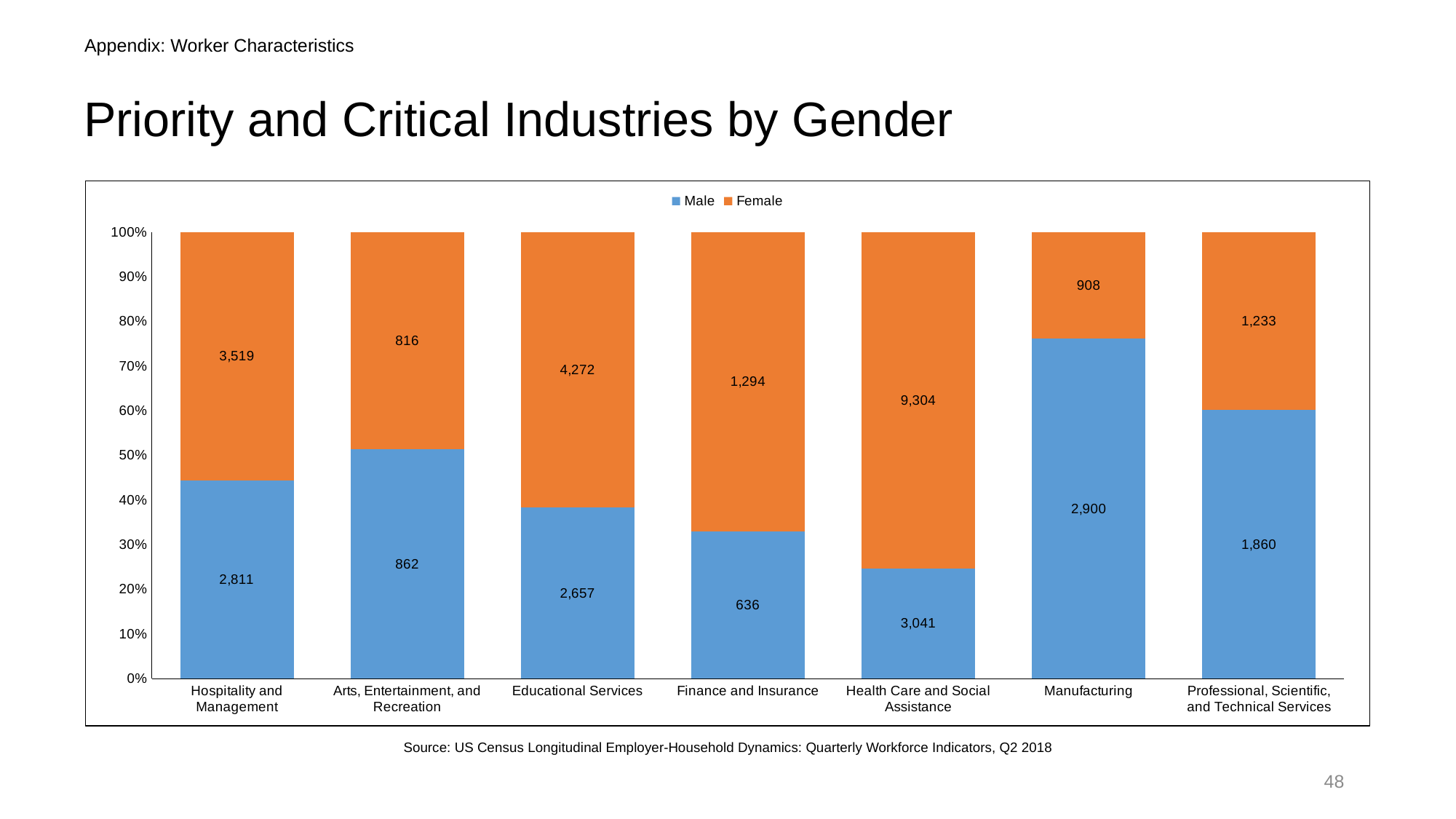
Which industry has the lowest Male value? Finance and Insurance Which is larger for Manufacturing, the Male value or the Female value? Male Which industry has the highest Female value? Health Care and Social Assistance What kind of chart is shown on the slide? Stacked bar chart How many industries are shown on the x axis? 7 What is the difference between the Female and Male values for Health Care and Social Assistance? 6,263 What is the total of the Male and Female values for Manufacturing? 3,808 What is the Male value for Health Care and Social Assistance? 3,041 What is the Male value for Finance and Insurance? 636 What is the Female value for Educational Services? 4,272 Is the Male share of the Manufacturing bar greater or less than 70%? greater How many series does the legend list? 2